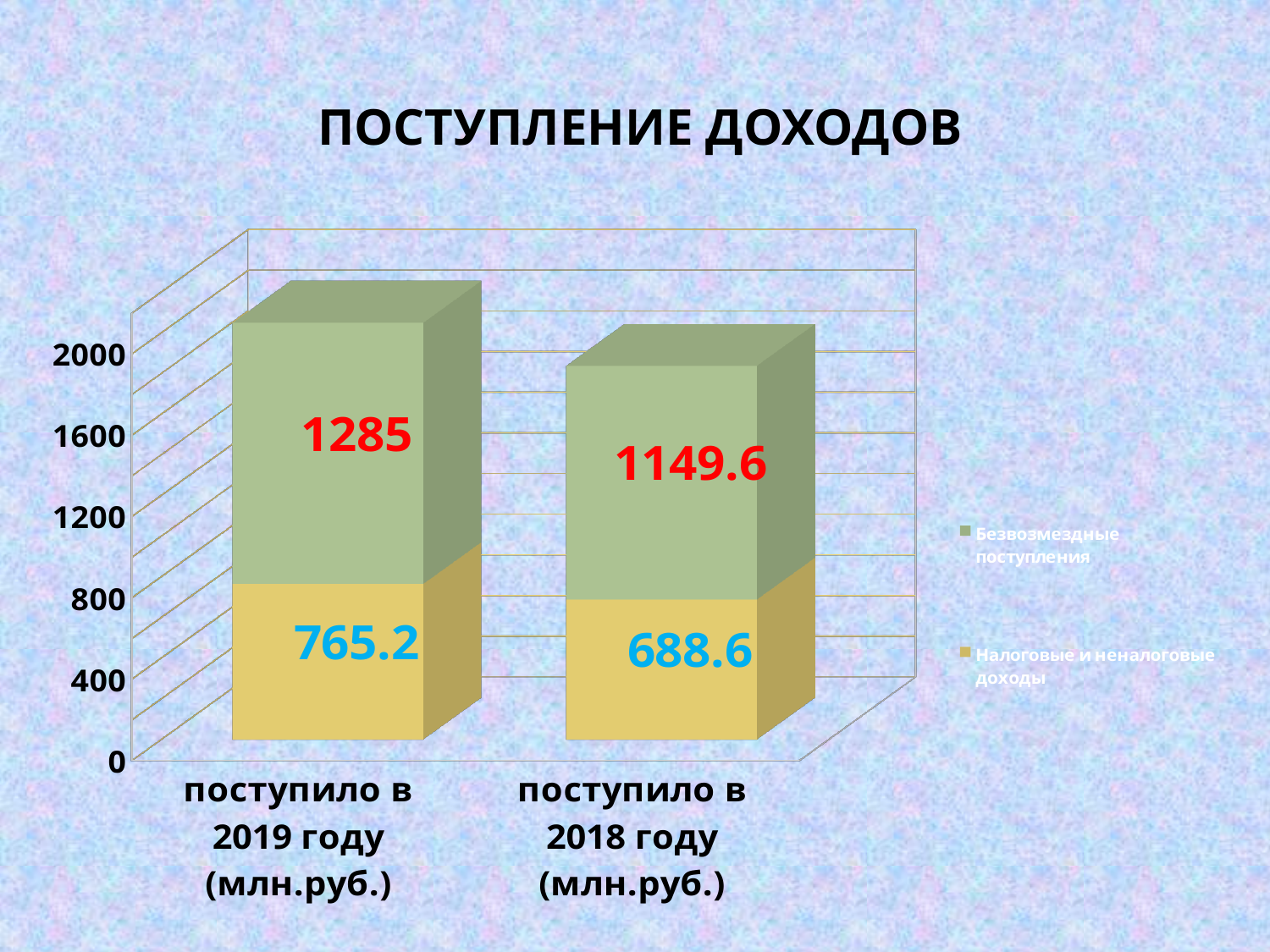
What is the total of the stacked bar for поступило в 2019 году? 2050.2 What is the value of Налоговые и неналоговые доходы for поступило в 2019 году? 765.2 Which year has the larger value for Налоговые и неналоговые доходы, 2019 or 2018? 2019 What is the value of Безвозмездные поступления for поступило в 2018 году? 1149.6 What type of chart is shown on the slide? Stacked bar chart What is the title of the chart? ПОСТУПЛЕНИЕ ДОХОДОВ How many categories are shown on the x axis? 2 What is the value of Безвозмездные поступления for поступило в 2019 году? 1285 What is the value of Налоговые и неналоговые доходы for поступило в 2018 году? 688.6 How many series does the legend list? 2 What is the total of the stacked bar for поступило в 2018 году? 1838.2 What is the difference between Безвозмездные поступления in 2019 and in 2018? 135.4